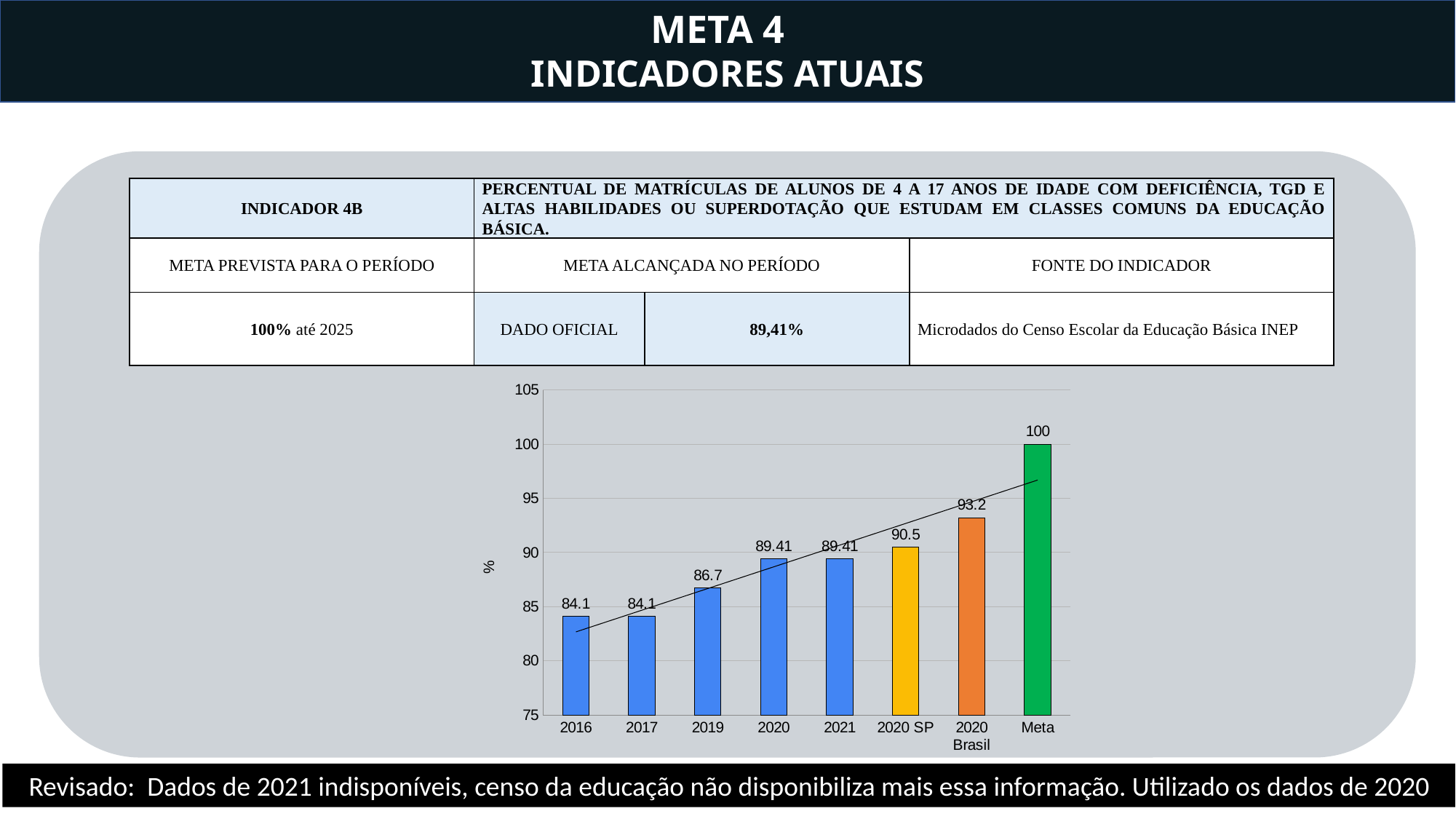
How many bars are shown in the chart? 8 Which is larger, the value for 2019 or the value for 2020? 2020 Is the value for 2016 greater or less than 85? less What is the difference between the Meta value and the 2021 value? 10.59 What label is shown on the vertical axis of the chart? % What is the difference between the 2020 Brasil value and the 2020 SP value? 2.7 Which category has the highest value? Meta What is the value for 2019? 86.7 What kind of chart is shown on the slide? bar chart What is the value for 2021? 89.41 What is the value for 2020 Brasil? 93.2 What is the value for 2020 SP? 90.5